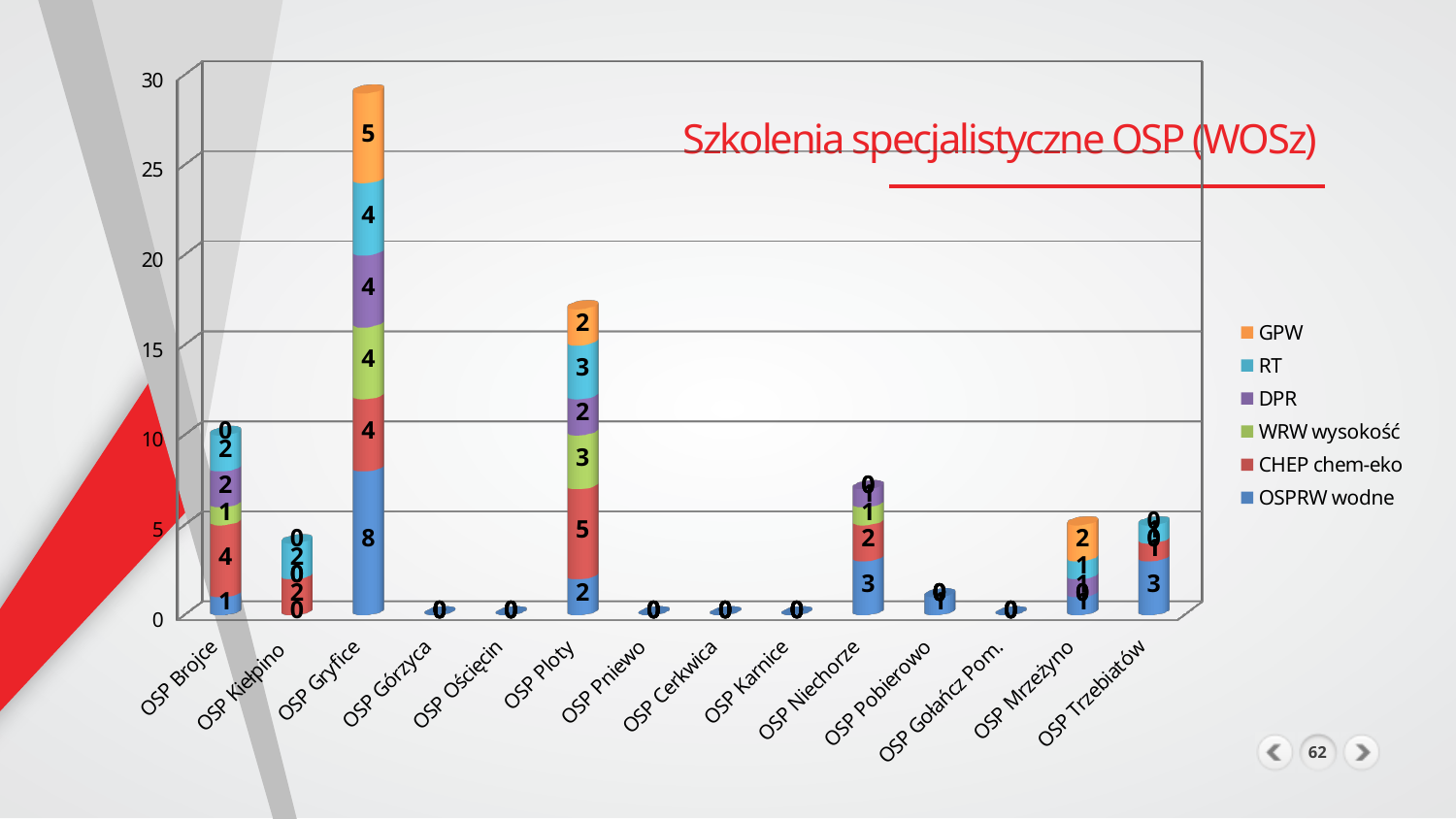
What is the total of the stacked bar for OSP Gryfice? 29 What is the total of the stacked bar for OSP Płoty? 17 What type of chart is shown on the slide? Stacked bar chart Which OSP unit has the tallest stacked bar? OSP Gryfice What is the CHEP chem-eko value for OSP Płoty? 5 What is the OSPRW wodne value for OSP Gryfice? 8 How many OSP units (categories) are shown on the x axis? 14 What is the difference between the OSPRW wodne values for OSP Gryfice and OSP Płoty? 6 What is the GPW value for OSP Gryfice? 5 How many series does the legend list? 6 What is the title of the chart? Szkolenia specjalistyczne OSP (WOSz) Is the total stacked value for OSP Gryfice greater or less than 25? greater